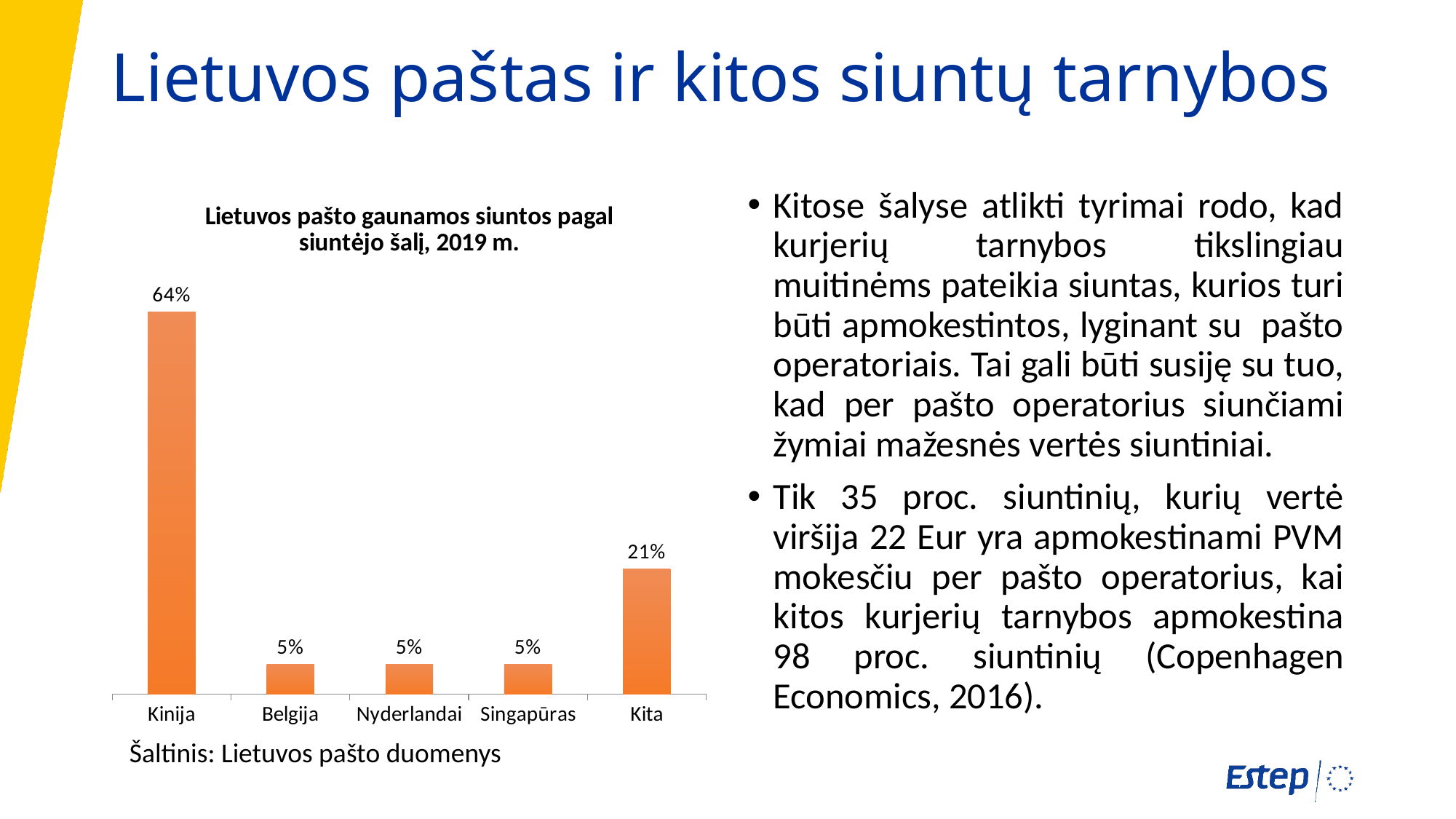
What kind of chart is shown on the slide? Bar chart What is the difference between the values for Kinija and Kita? 43% What is the value for Kita? 21% Which category has the highest value? Kinija What is the value for Kinija? 64% Which is larger, the value for Kita or the value for Nyderlandai? Kita What is the difference between the values for Kita and Singapūras? 16% What is the value for Belgija? 5% What is the title of the chart? Lietuvos pašto gaunamos siuntos pagal siuntėjo šalį, 2019 m. How many categories are shown on the x axis? 5 What source is cited below the chart? Lietuvos pašto duomenys How many categories share the value 5%? 3